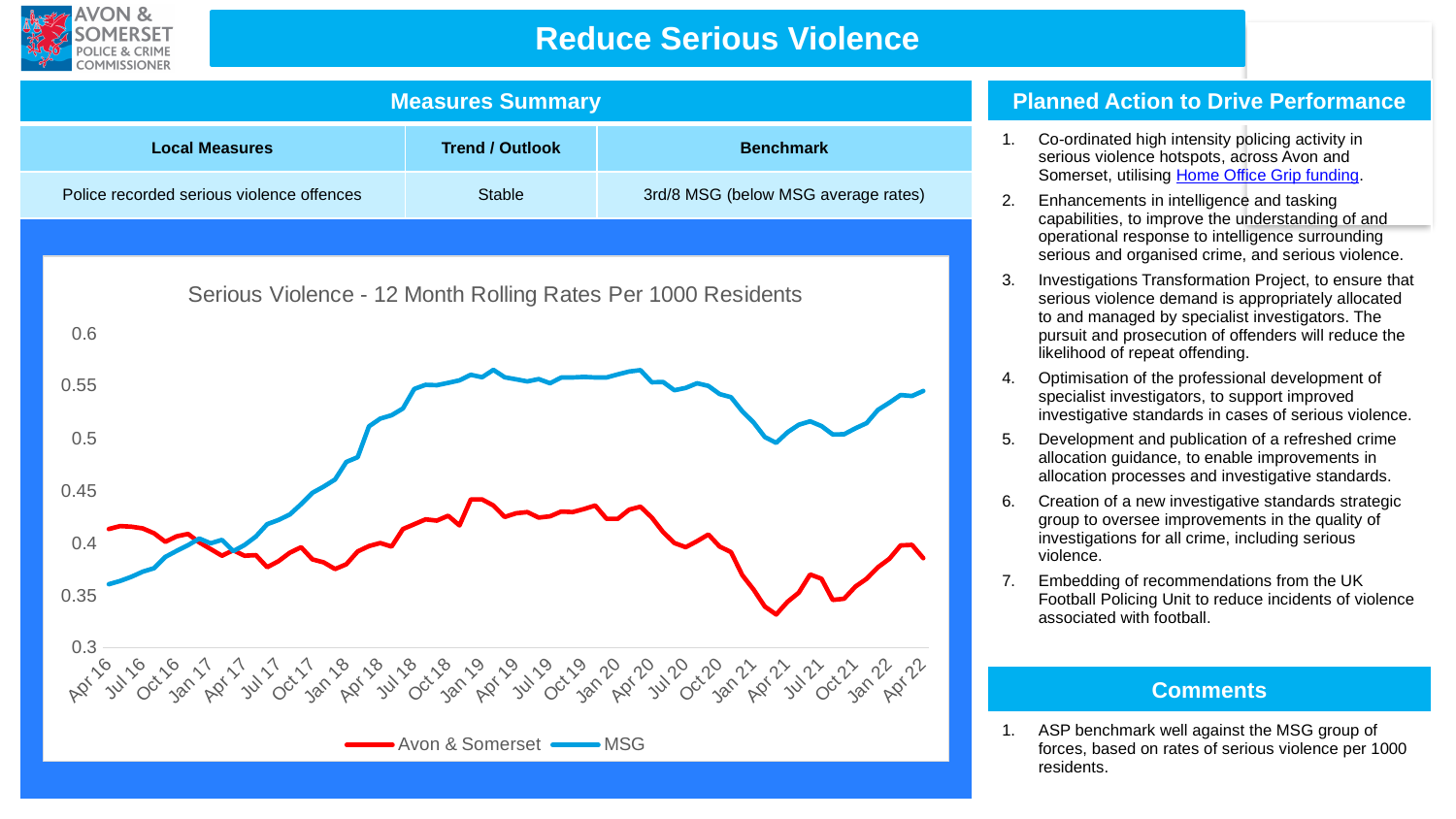
Is the MSG value at Jan 20 greater or less than 0.55? greater How many series does the chart legend list? 2 What is the title of the chart? Serious Violence - 12 Month Rolling Rates Per 1000 Residents At Apr 22, which series has the higher value, Avon & Somerset or MSG? MSG Which colour is used for the Avon & Somerset line? Red At Apr 16, which series has the higher value, Avon & Somerset or MSG? Avon & Somerset Is the MSG value at Apr 22 greater or less than 0.5? greater How many date labels are shown along the x axis? 25 What kind of chart is shown on the slide? Line chart Does the MSG line rise or fall overall from Apr 16 to Apr 22? Rise Is the MSG value at Apr 16 greater or less than 0.4? less